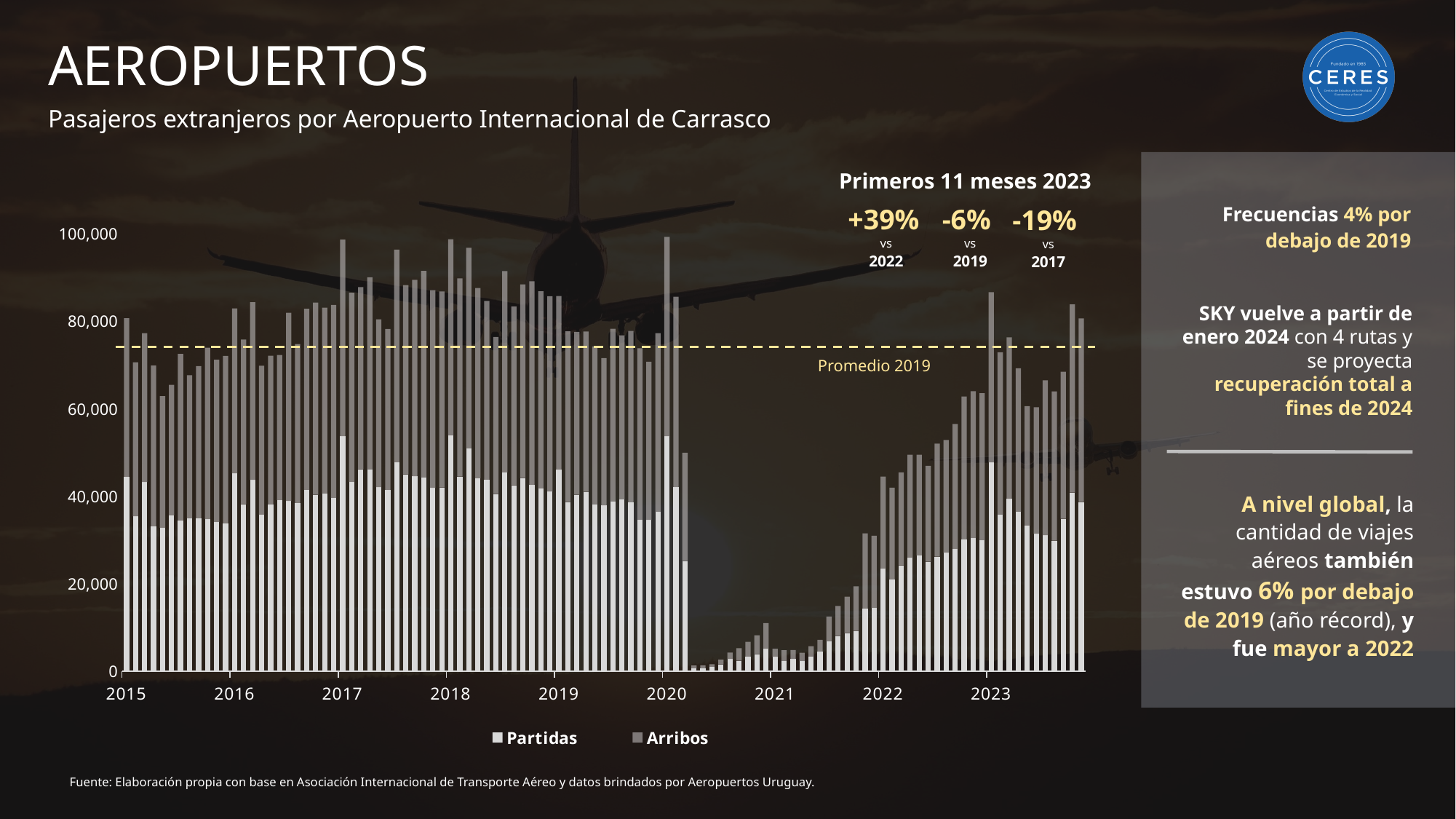
What kind of chart is shown on the slide? bar chart What are the two series named in the chart legend? Partidas and Arribos Is the dashed 'Promedio 2019' line greater or less than 80,000? less Is the value for the first bar of 2021 greater or less than 20,000? less How many year labels appear on the x axis of the chart? 9 Is the dashed 'Promedio 2019' line greater or less than 60,000? greater According to the annotation, what is the change in the first 11 months of 2023 versus 2019? -6% Do the values rise or fall from 2021 to 2023? rise How many series does the chart legend list? 2 What does the dashed horizontal line on the chart represent? Promedio 2019